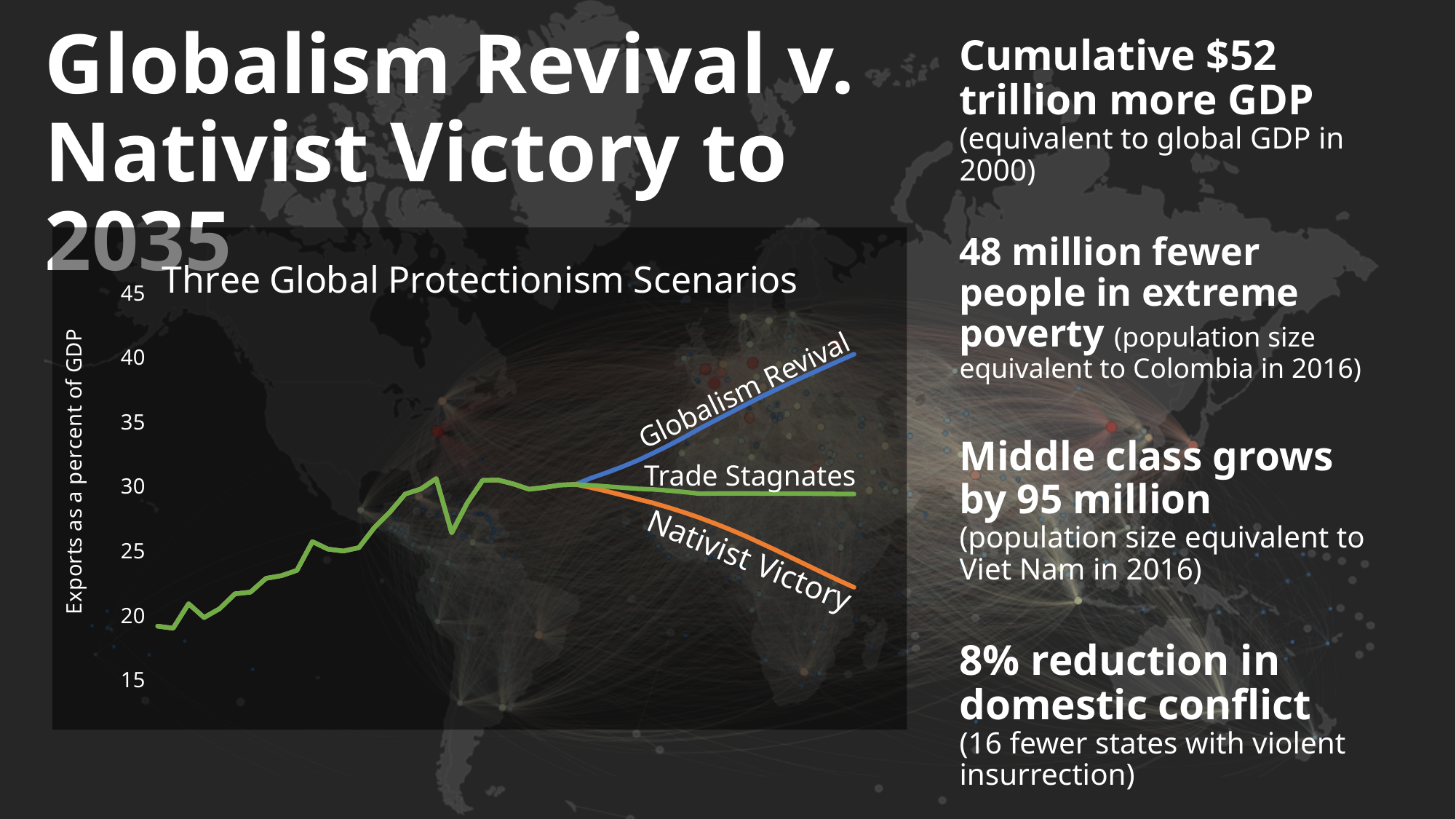
Which scenario ends higher, Trade Stagnates or Nativist Victory? Trade Stagnates What kind of chart is shown on the slide? line chart How many scenarios are plotted in the chart? 3 Which scenario ends with the lowest exports as a percent of GDP? Nativist Victory Is the starting value of the line at the far left greater or less than 25? less What is the label on the vertical axis of the chart? Exports as a percent of GDP Which scenario ends with the highest exports as a percent of GDP? Globalism Revival Is the final value of the Trade Stagnates line greater or less than 25? greater Is the final value of the Nativist Victory line greater or less than 25? less Does the historical portion of the line generally rise or fall from left to right before the scenarios split? rise What is the title of the chart? Three Global Protectionism Scenarios